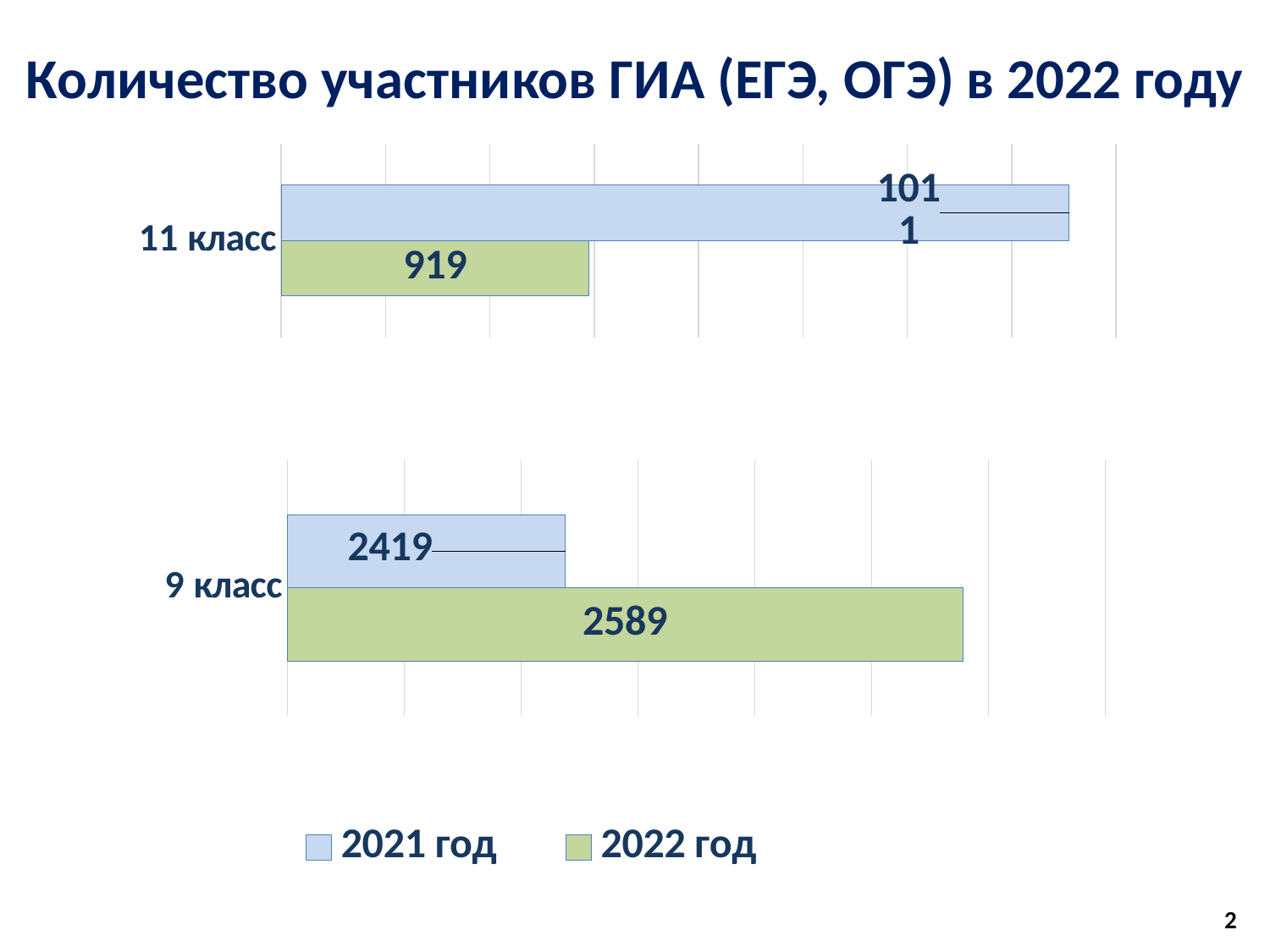
For 11 класс, which series has the larger value, 2021 год or 2022 год? 2021 год How many series does the legend list? 2 What is the title of the chart? Количество участников ГИА (ЕГЭ, ОГЭ) в 2022 году What is the value for 9 класс in the 2021 год series? 2419 How many categories (classes) are shown in the chart? 2 Which category has the highest value in the 2022 год series? 9 класс What is the difference between the 2022 год and 2021 год values for 9 класс? 170 What is the value for 11 класс in the 2022 год series? 919 What is the value for 9 класс in the 2022 год series? 2589 What is the value for 11 класс in the 2021 год series? 1011 For 9 класс, which series has the larger value, 2021 год or 2022 год? 2022 год What kind of chart is shown on the slide? bar chart